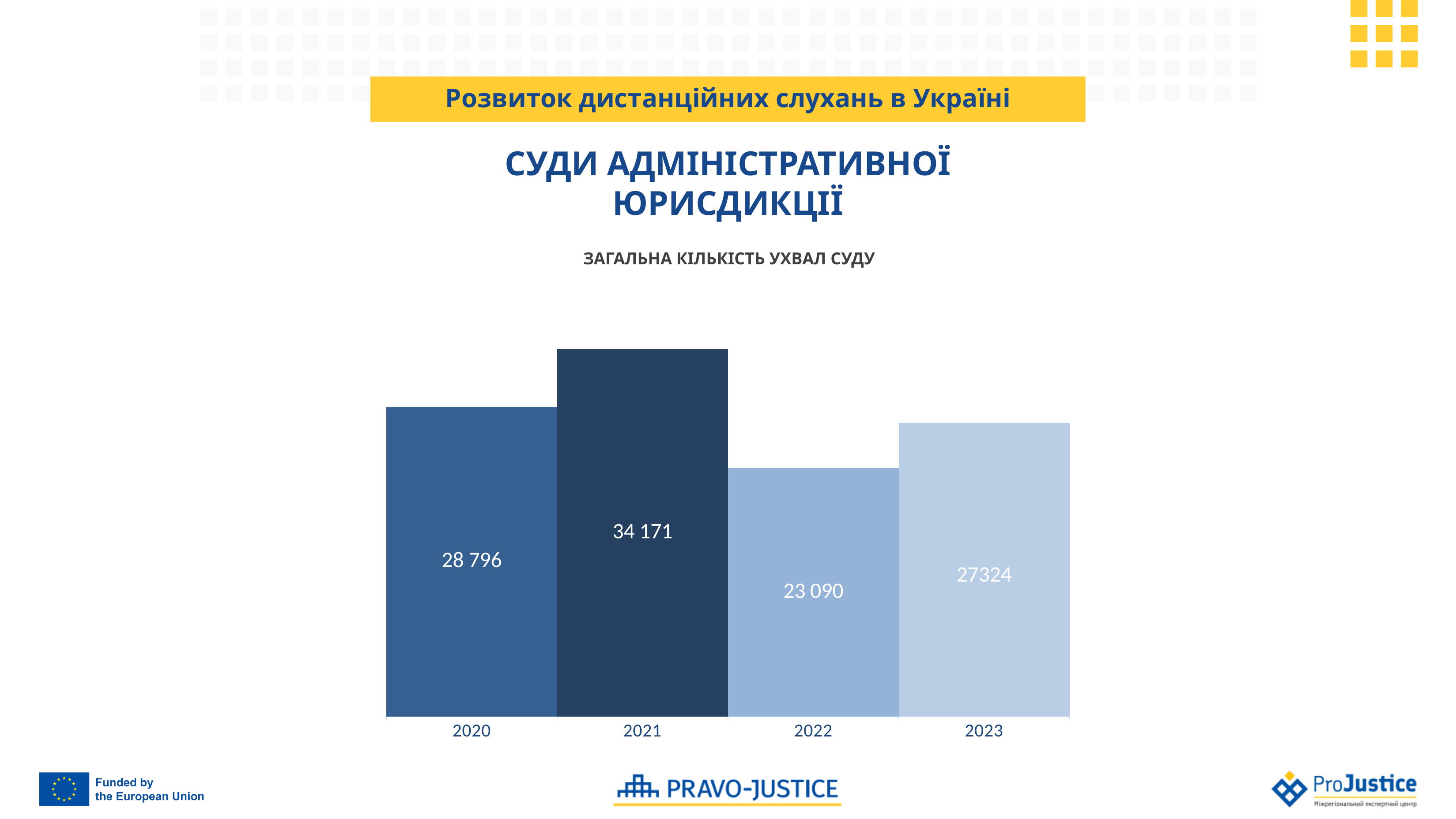
What is the difference between the values for 2020 and 2022? 5 706 What is the value for 2022? 23 090 What is the difference between the values for 2021 and 2020? 5 375 How many years are shown on the chart? 4 What is the value for 2020? 28 796 Which year has the highest value? 2021 What is the value for 2023? 27324 What is the title of the chart? ЗАГАЛЬНА КІЛЬКІСТЬ УХВАЛ СУДУ What is the value for 2021? 34 171 Which is larger, the value for 2020 or the value for 2023? 2020 Which year has the lowest value? 2022 What kind of chart is shown on the slide? bar chart